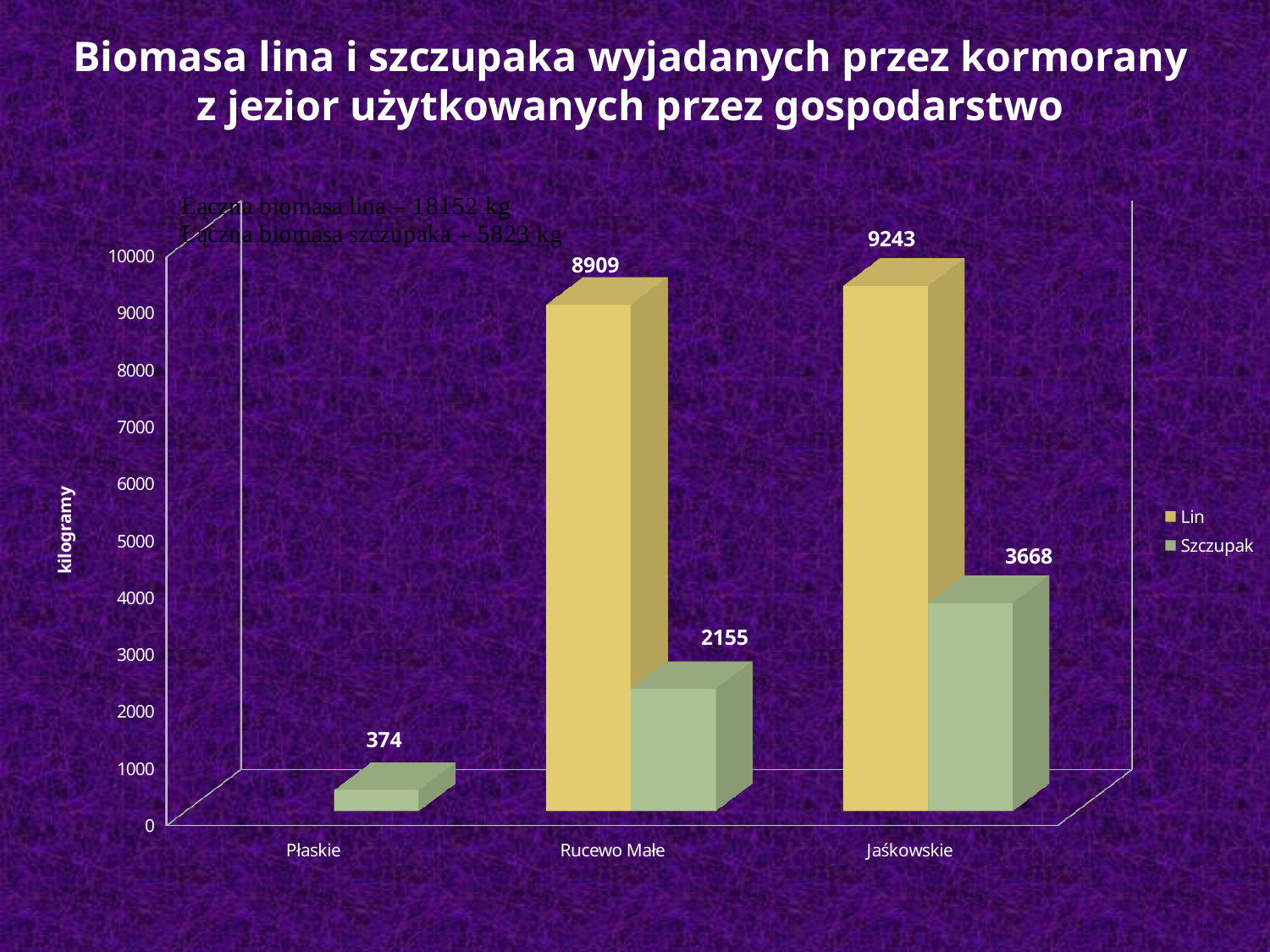
What is the difference between the Lin and Szczupak values for Rucewo Małe? 6754 Which lake has the highest Lin value? Jaśkowskie What is the difference between the Szczupak values for Jaśkowskie and Rucewo Małe? 1513 Which is larger: the Szczupak value for Jaśkowskie or the Szczupak value for Rucewo Małe? Jaśkowskie Which lake has the lowest Szczupak value? Płaskie What is the Szczupak value for Płaskie? 374 How many series does the legend list? 2 How many lakes (categories) are shown on the x axis? 3 What is the Lin value for Rucewo Małe? 8909 What is the Lin value for Jaśkowskie? 9243 What is the Szczupak value for Jaśkowskie? 3668 What kind of chart is shown on the slide? bar chart